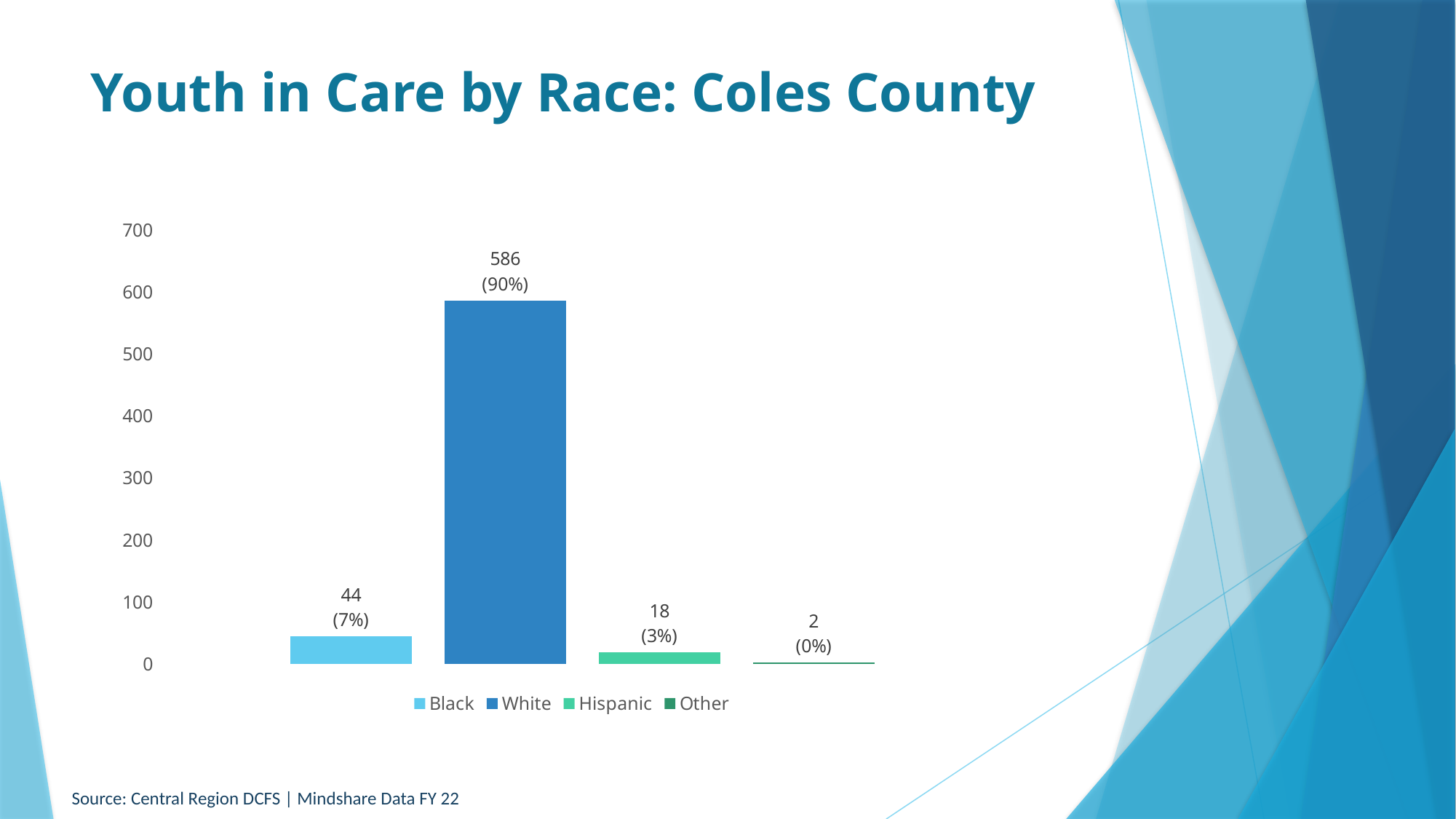
Which is larger, the value for Black or the value for Hispanic? Black What is the number of youth in care for Black? 44 Which race category has the lowest number of youth in care? Other What kind of chart is shown on the slide? Bar chart Is the value for White greater or less than 500? greater Which race category has the highest number of youth in care? White What percentage is shown for the Other category? 0% How many race categories are shown in the chart? 4 What is the difference between the White and Black values? 542 What is the number of youth in care for Hispanic? 18 What is the difference between the Black and Hispanic values? 26 What is the number of youth in care for White? 586